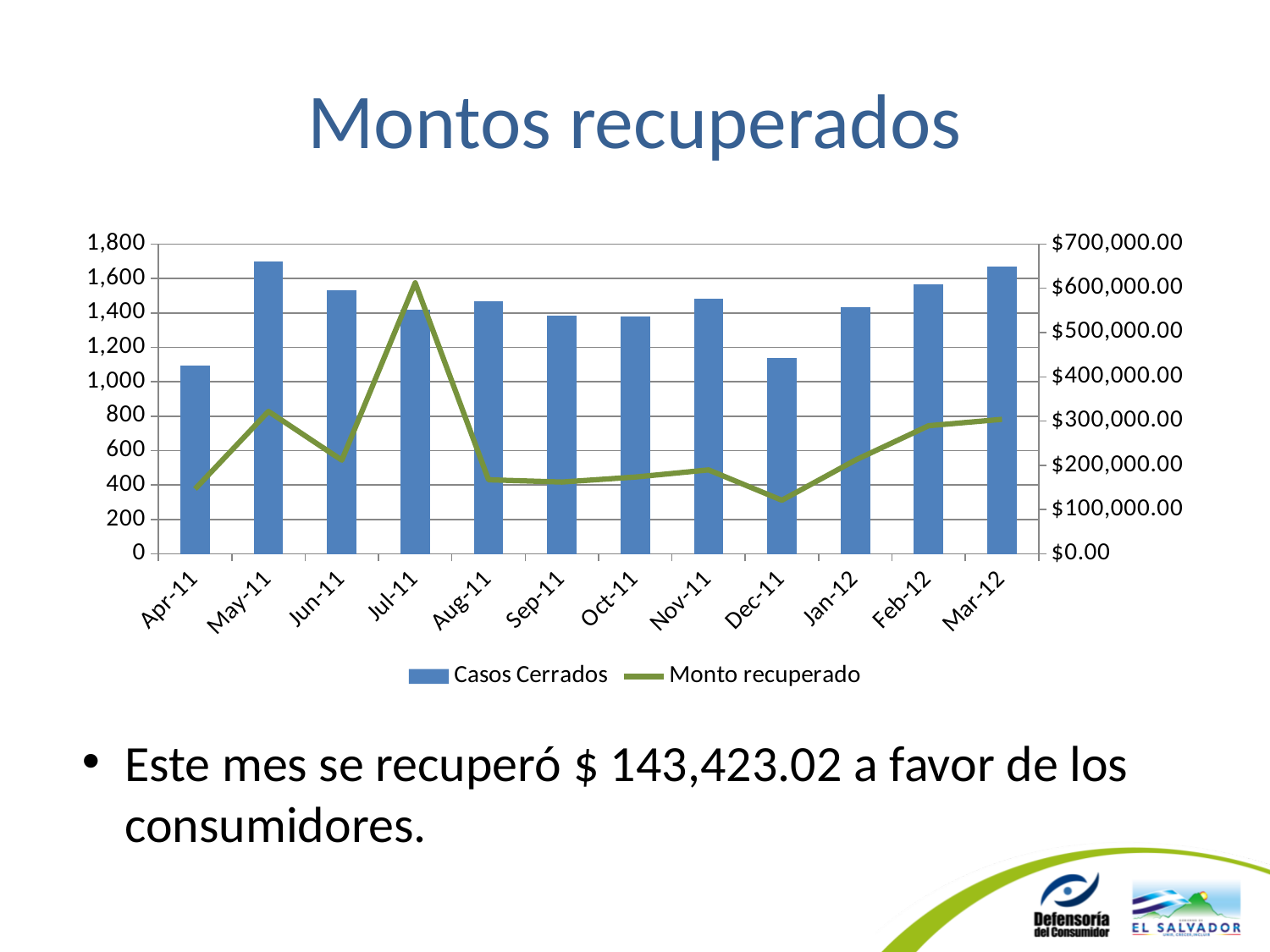
Is the Casos Cerrados value for Apr-11 greater or less than 1,200? less Which month has the lowest Monto recuperado? Dec-11 Which month has more Casos Cerrados, Jun-11 or Sep-11? Jun-11 What kind of chart is shown? Combined bar and line chart What is the title of the chart? Montos recuperados Does the Monto recuperado rise or fall from Dec-11 to Mar-12? rise How many months are shown on the x axis? 12 Which month has a higher Monto recuperado, May-11 or Aug-11? May-11 Is the Casos Cerrados value for May-11 greater or less than 1,600? greater How many series does the legend list? 2 Is the Monto recuperado for Jul-11 greater or less than $500,000.00? greater Which month has the highest Monto recuperado? Jul-11